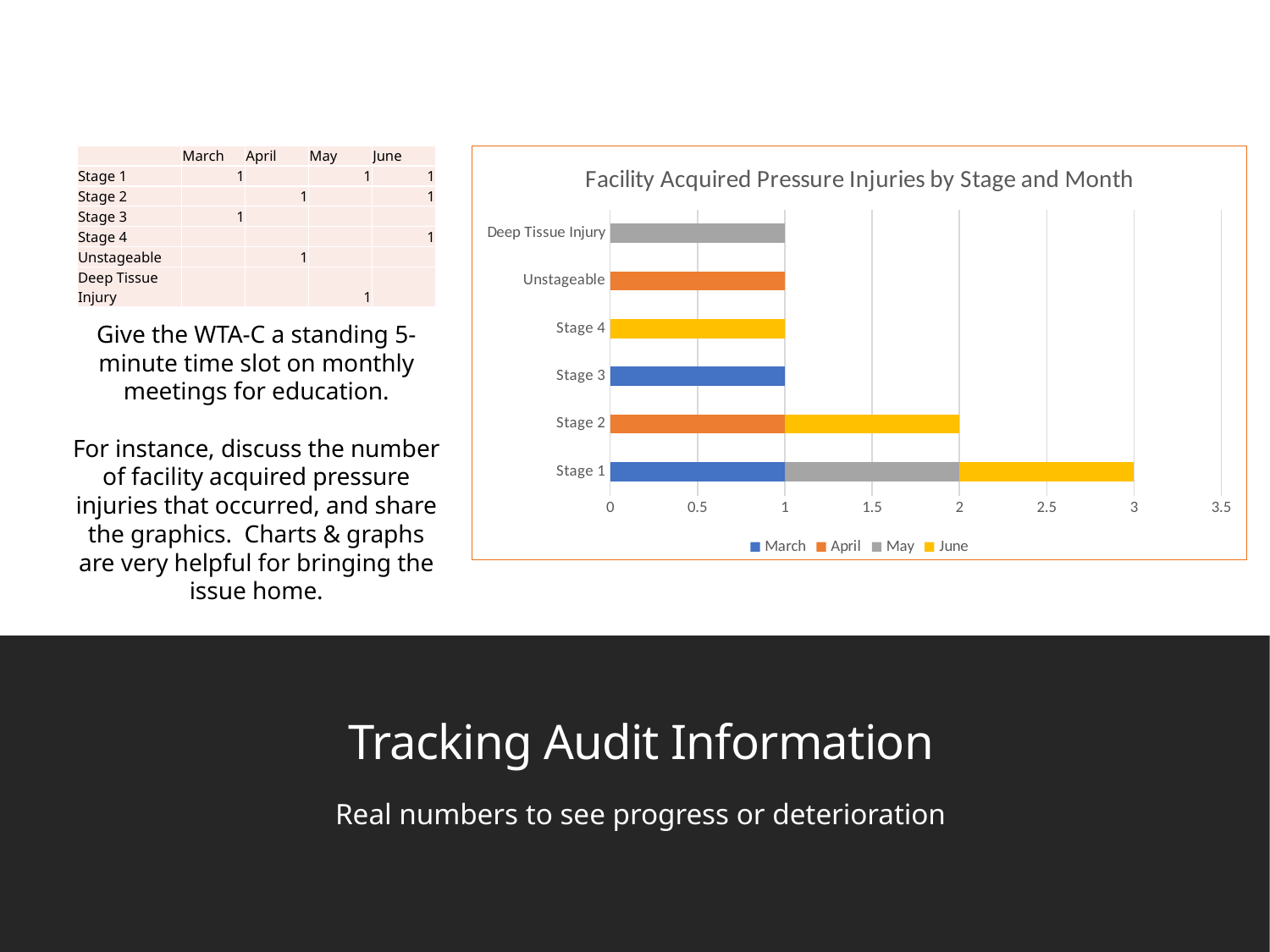
How many stage categories are plotted on the chart? 6 What is the title of the chart? Facility Acquired Pressure Injuries by Stage and Month What is the value for Unstageable in April? 1 Which has the longer stacked bar, Stage 2 or Stage 4? Stage 2 What is the total length of the stacked bar for Stage 2? 2 Which month is the Deep Tissue Injury bar attributed to? May What is the total length of the stacked bar for Stage 1? 3 What kind of chart is shown on the slide? Stacked bar chart Which category has the longest stacked bar? Stage 1 What is the value for Stage 3 in March? 1 How many series does the chart legend list? 4 Is the total for Stage 1 greater or less than 2? greater